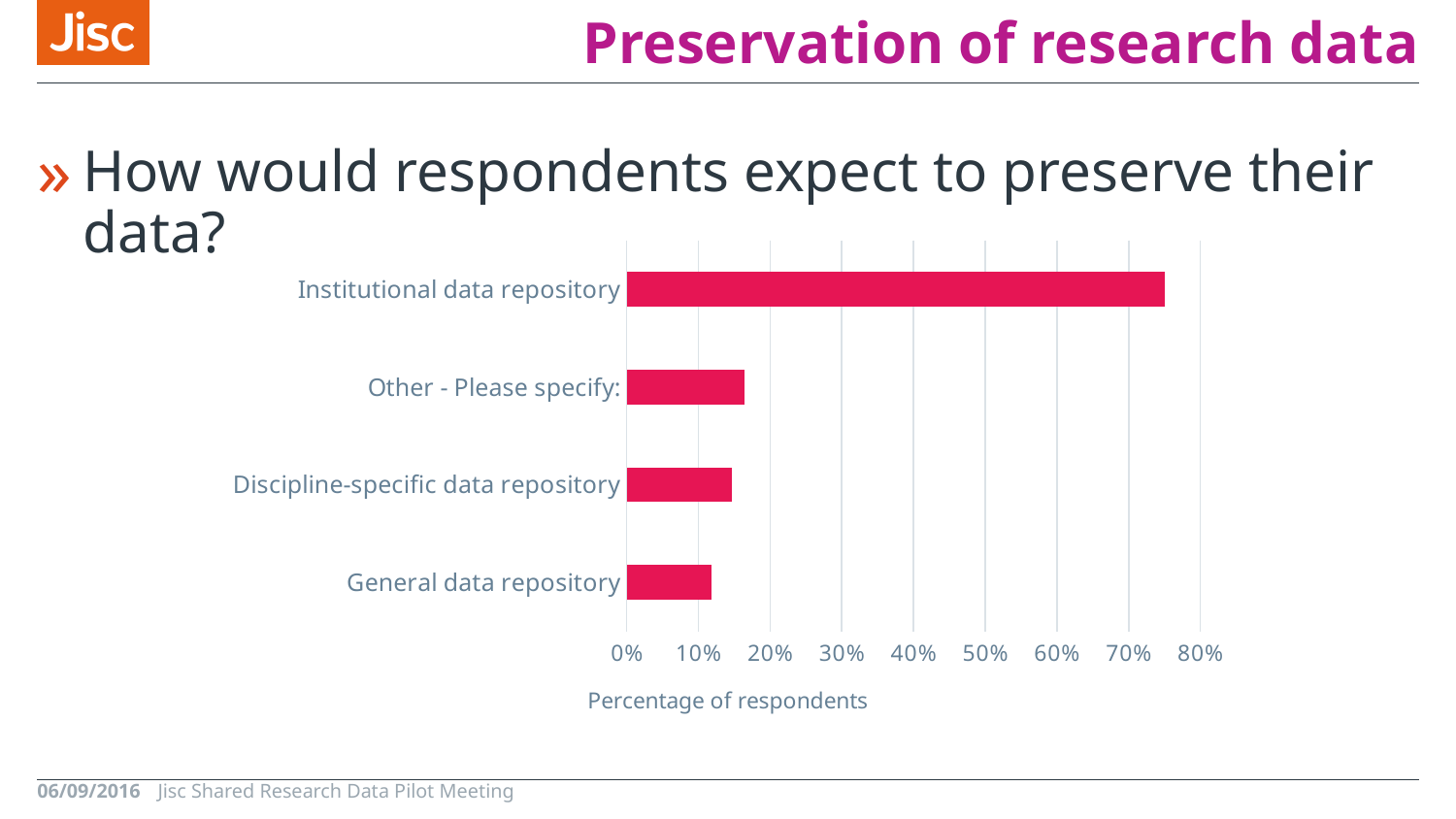
What kind of chart is shown on the slide? Bar chart Is the value for Institutional data repository greater or less than 80%? less What is the highest value shown on the horizontal axis? 80% Which is larger, the value for Institutional data repository or the value for General data repository? Institutional data repository Is the value for Discipline-specific data repository greater or less than 10%? greater Which category has the highest percentage of respondents? Institutional data repository Is the value for Other - Please specify: greater or less than 20%? less How many categories are plotted in the chart? 4 What is the title of the horizontal axis? Percentage of respondents Which category has the lowest percentage of respondents? General data repository